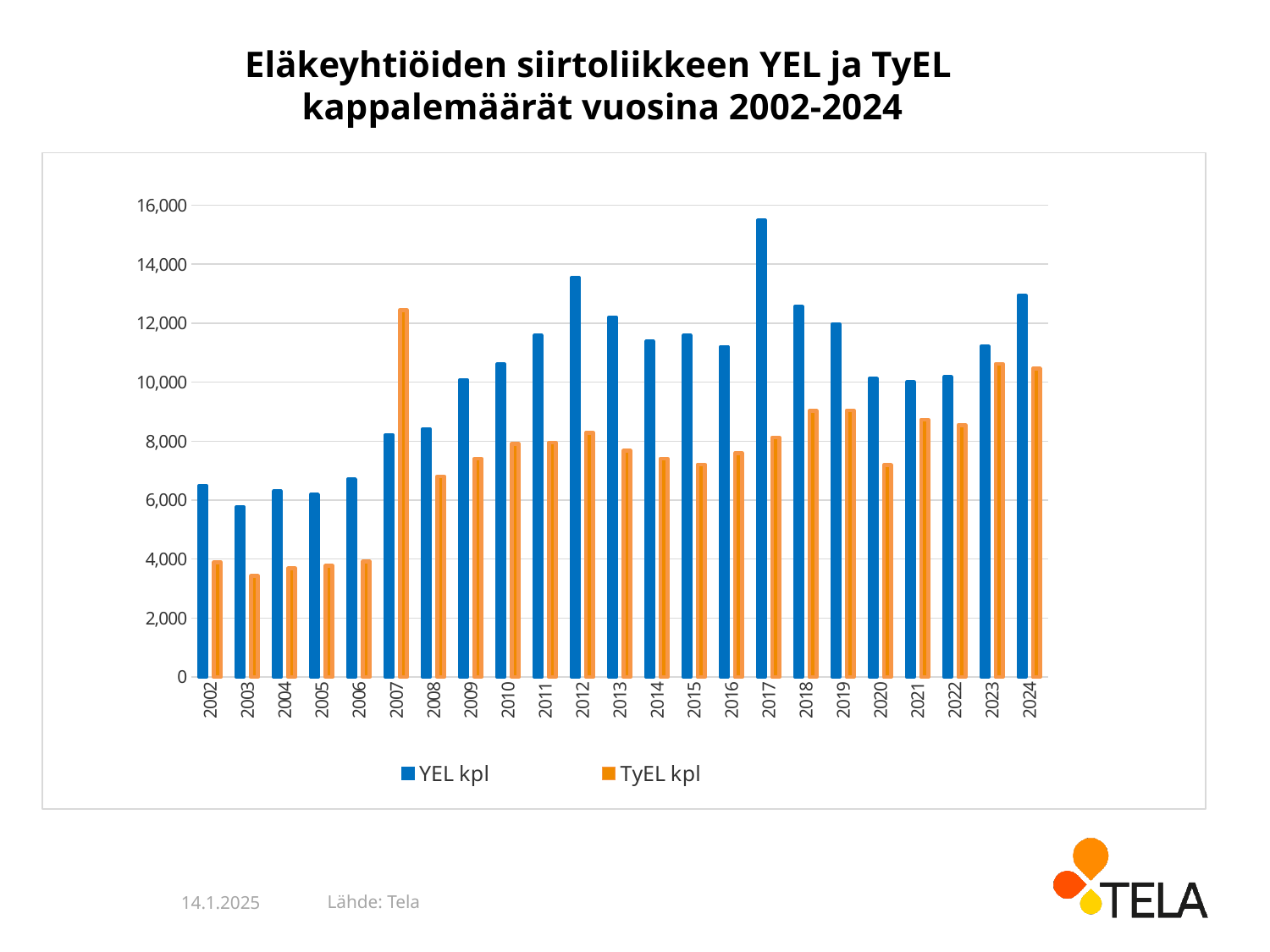
In which year is the YEL kpl value highest? 2017 Is the YEL kpl value for 2017 greater or less than 14,000? greater In which year is the YEL kpl value lowest? 2003 In which year is the TyEL kpl value highest? 2007 In 2007, which is larger, YEL kpl or TyEL kpl? TyEL kpl How many years are shown on the x axis? 23 How many series does the legend list? 2 Does the YEL kpl value rise or fall from 2021 to 2024? rise Is the TyEL kpl value for 2003 greater or less than 4,000? less Which colour represents TyEL kpl in the chart? orange Is the TyEL kpl value for 2007 greater or less than 12,000? greater What kind of chart is shown on the slide? bar chart